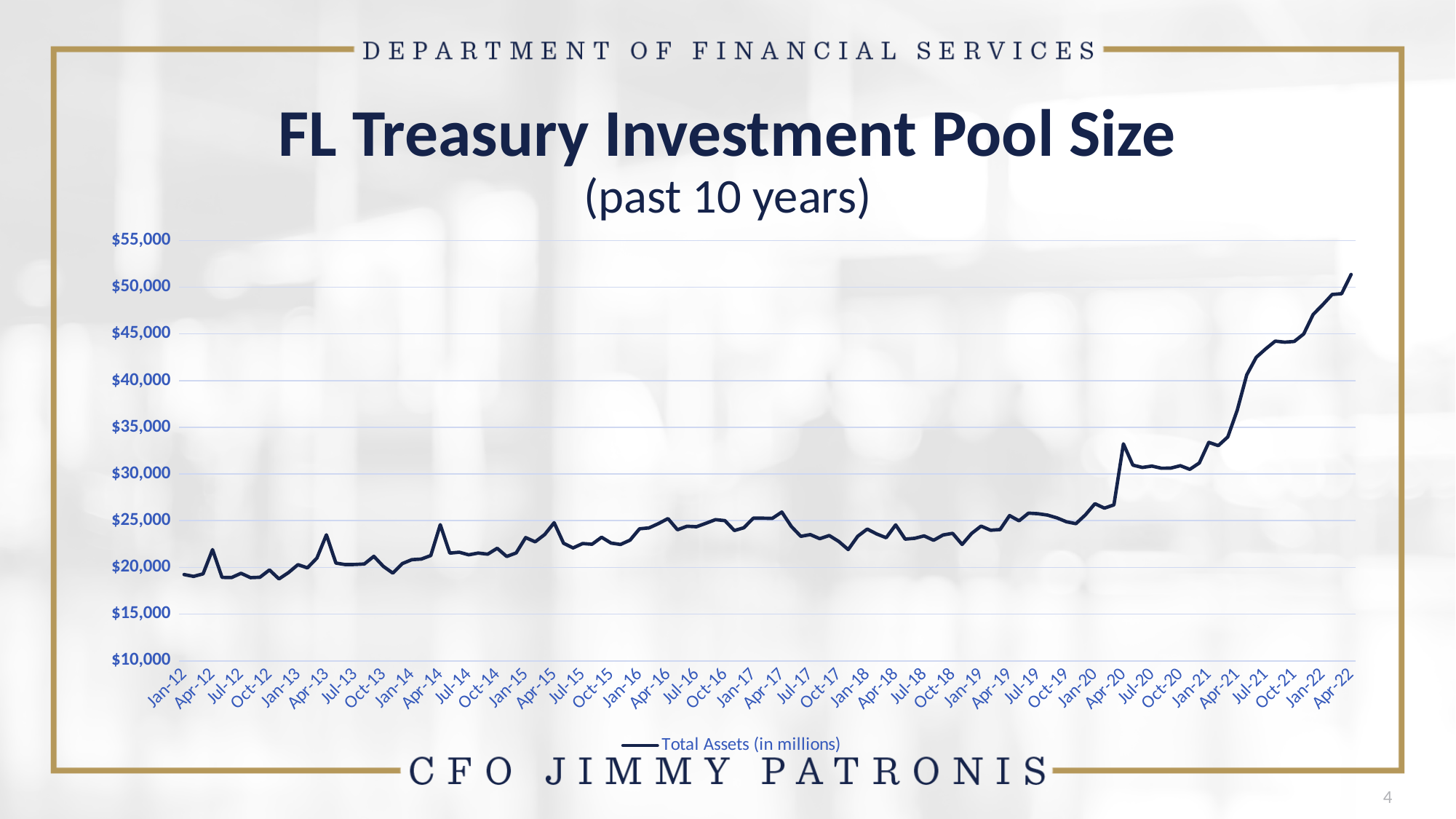
How many series does the legend list? 1 Is the value for Apr-20 greater or less than $30,000? greater Which point on the x axis has the highest value? Apr-22 Which is larger, the value for Apr-20 or the value for Jan-20? Apr-20 What kind of chart is shown on the slide? line chart Is the value for Apr-22 greater or less than $50,000? greater Overall, do the values rise or fall from Jan-12 to Apr-22? rise What is the name of the series shown in the legend? Total Assets (in millions) Is the value for Jan-12 greater or less than $20,000? less What is the title of the chart? FL Treasury Investment Pool Size (past 10 years) Which is larger, the value for Jul-21 or the value for Jul-20? Jul-21